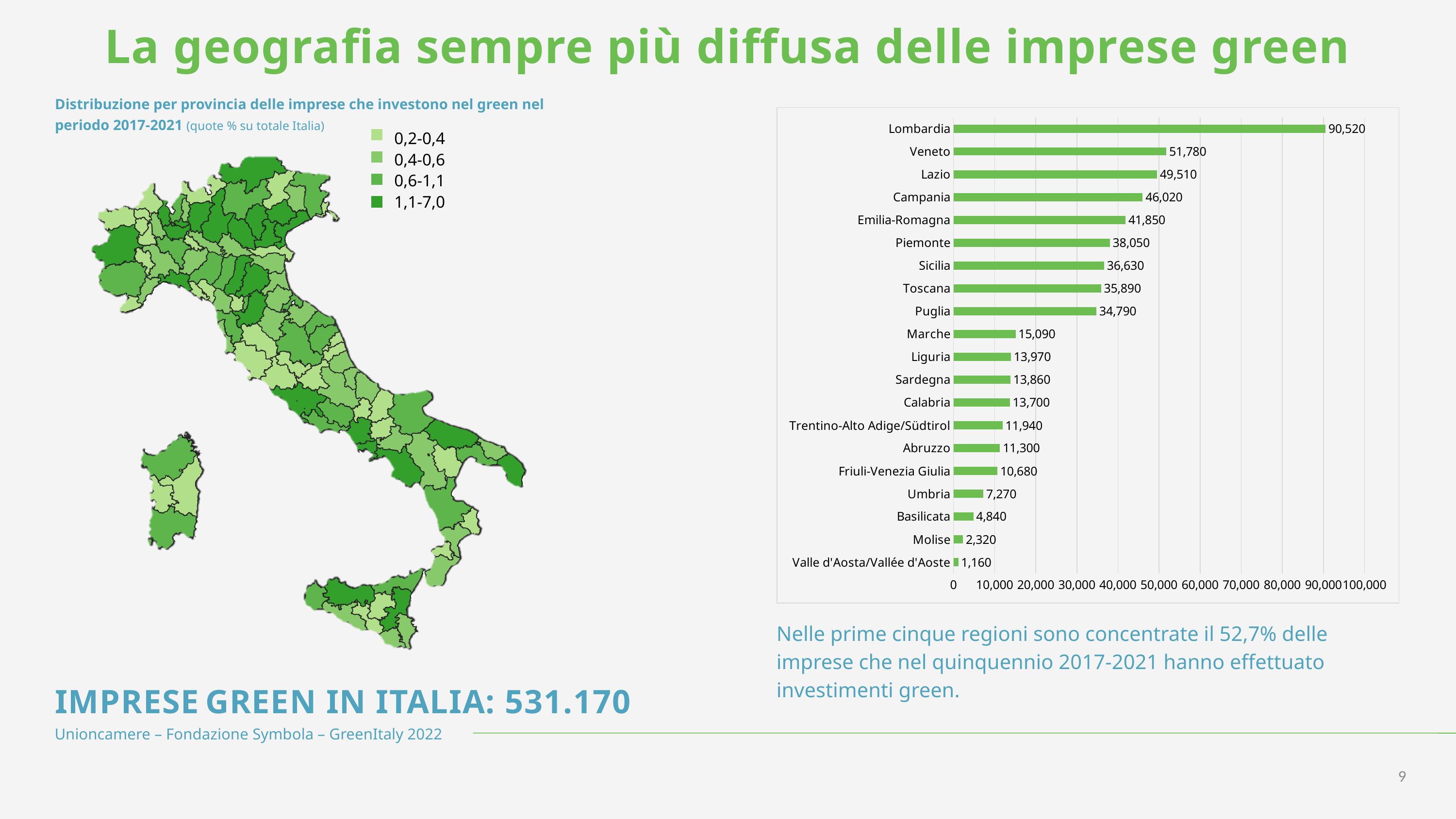
In the bar chart on the right, what is the value for Emilia-Romagna? 41,850 In the bar chart on the right, which has a larger value, Sicilia or Toscana? Sicilia How many regions are shown in the bar chart on the right? 20 In the bar chart on the right, which region has the lowest value? Valle d'Aosta/Vallée d'Aoste In the bar chart on the right, what is the value for Friuli-Venezia Giulia? 10,680 In the bar chart on the right, what is the difference between the values for Lombardia and Veneto? 38,740 In the bar chart on the right, what is the difference between the values for Marche and Umbria? 7,820 How many value ranges does the legend of the map on the left list? 4 In the bar chart on the right, is the value for Piemonte greater or less than 40,000? less What kind of chart is shown on the right side of the slide? bar chart In the bar chart on the right, which region has the highest value? Lombardia In the bar chart on the right, what is the value for Lombardia? 90,520